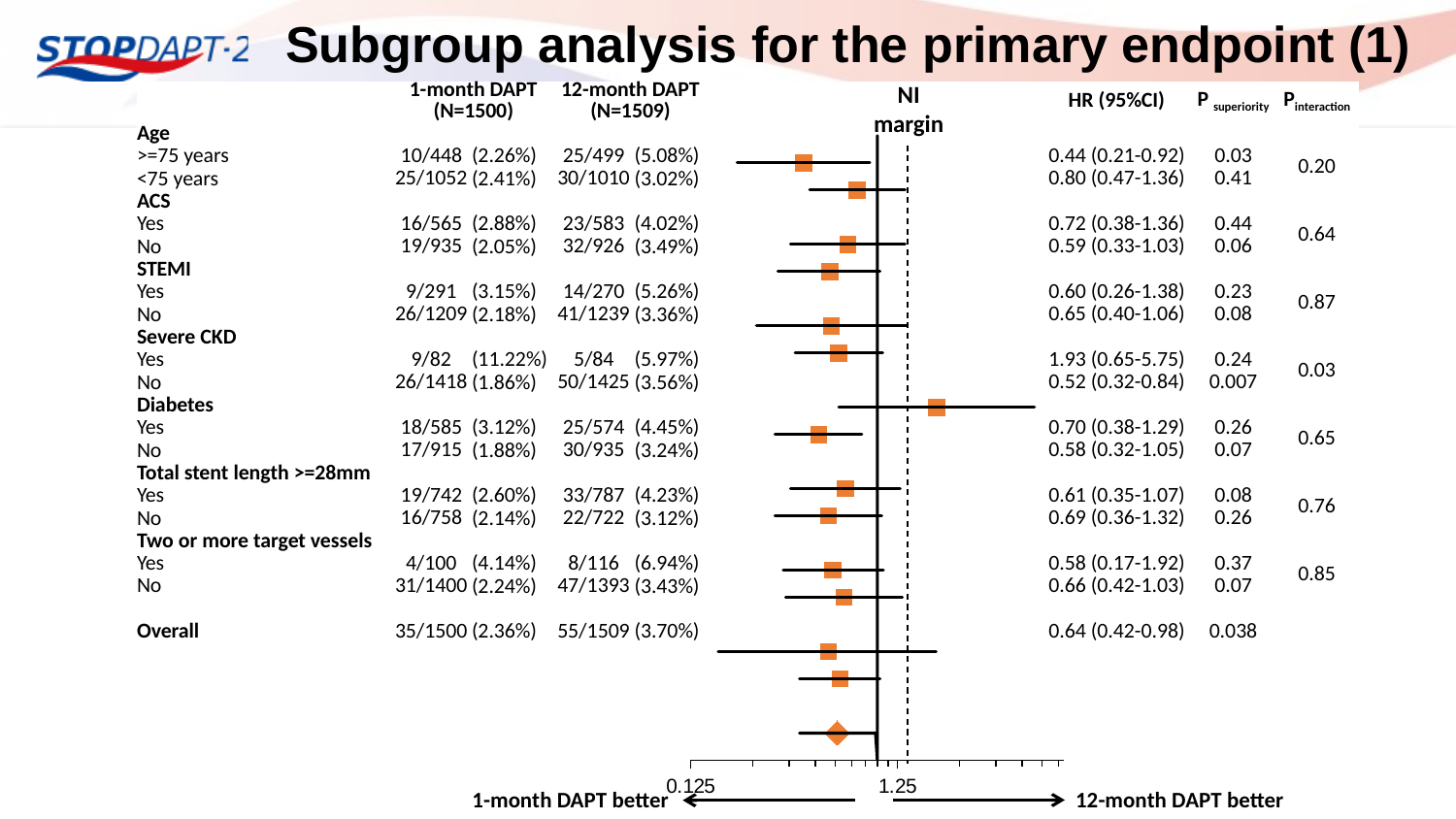
Is the hazard ratio for the Severe CKD 'Yes' subgroup greater or less than 1.25? greater What is the Overall HR (95%CI)? 0.64 (0.42-0.98) What is the difference in the number of Overall events between 12-month DAPT (55) and 1-month DAPT (35)? 20 What is the HR (95%CI) for the Severe CKD 'Yes' subgroup? 1.93 (0.65-5.75) What is the P superiority value for the Severe CKD 'No' subgroup? 0.007 What kind of chart is shown on the slide? Forest plot Which subgroup has the lowest hazard ratio? >=75 years How many subgroup variables (e.g., Age, ACS) are listed in the forest plot? 7 Which subgroup has the highest hazard ratio? Severe CKD Yes What is the 1-month DAPT event rate for patients aged >=75 years? 10/448 (2.26%) Is the hazard ratio for the Diabetes 'Yes' subgroup larger or smaller than for the Diabetes 'No' subgroup? Larger Which subgroup has the lowest P interaction value? Severe CKD